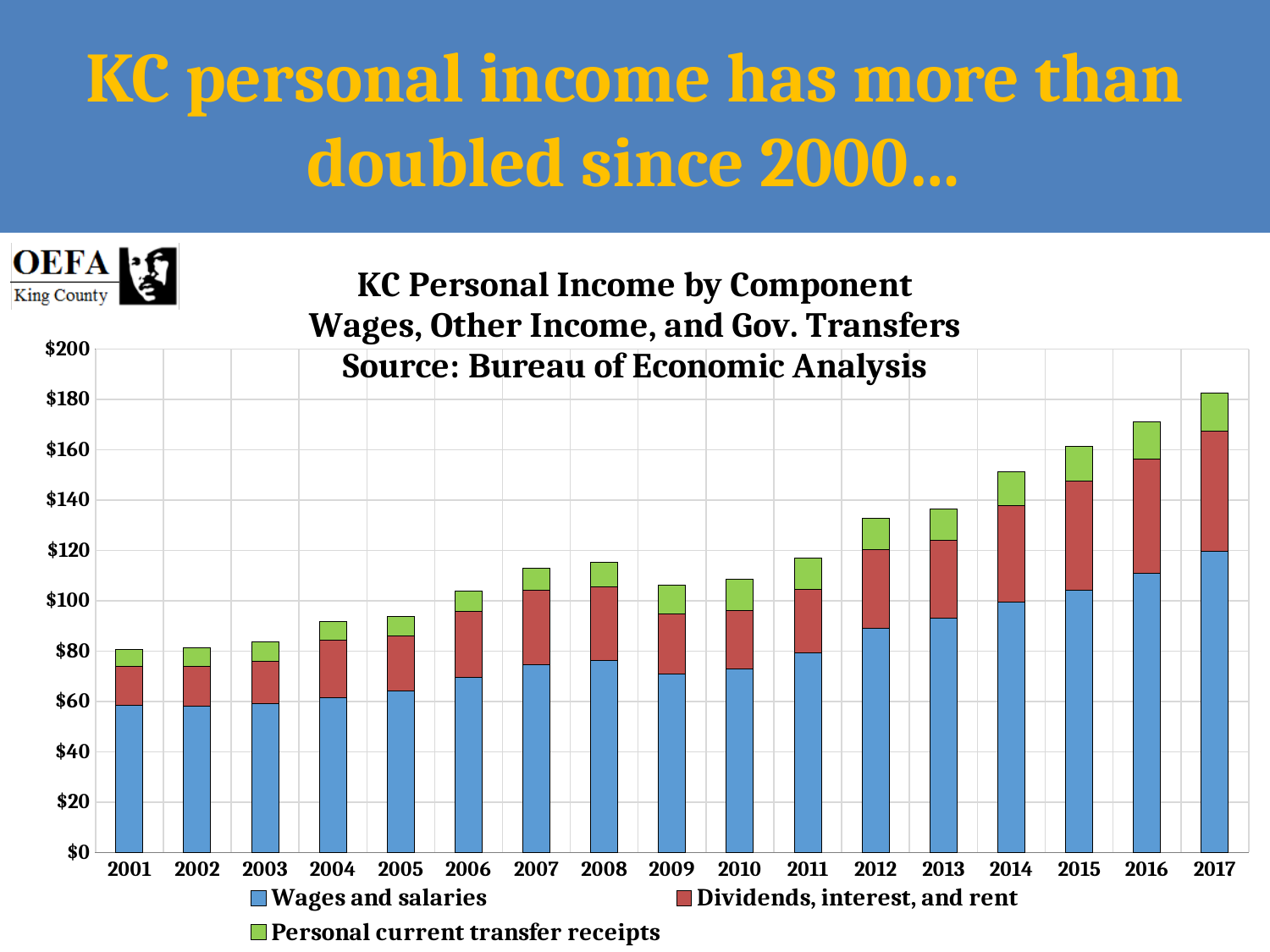
Which year has the larger total bar, 2015 or 2016? 2016 Which year has the highest total personal income in the chart? 2017 Which series is shown in green in the chart? Personal current transfer receipts Is the Wages and salaries segment for 2017 greater or less than $100? greater How many series does the chart's legend list? 3 Is the total bar for 2017 greater or less than $160? greater Is the total bar for 2009 greater or less than $120? less How many years are shown on the x axis of the chart? 17 According to the chart title, what is the source of the data? Bureau of Economic Analysis What kind of chart is shown on the slide? Stacked bar chart Do the total bar heights generally rise or fall from 2001 to 2017? Rise